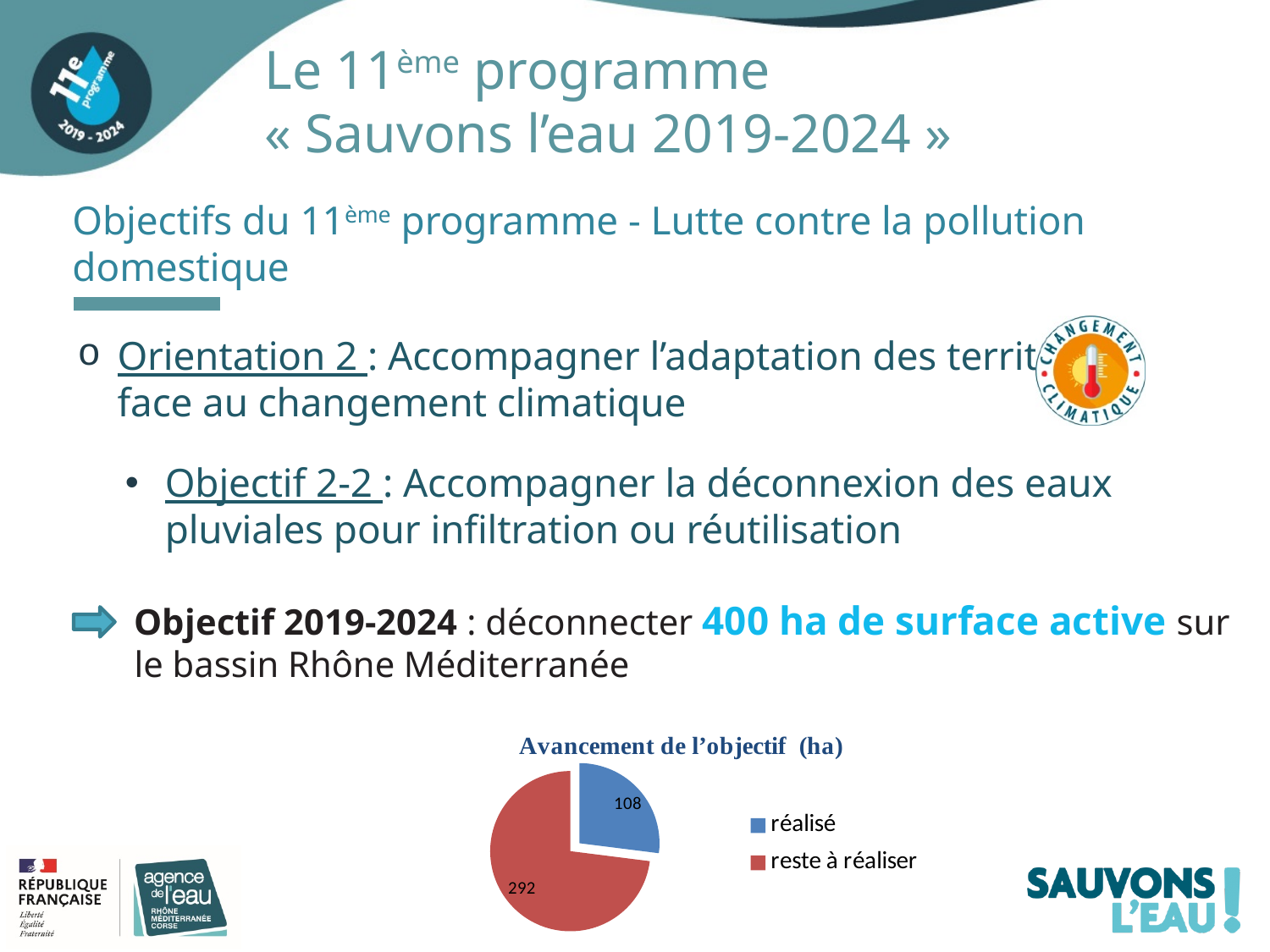
What is the value for "réalisé" in the pie chart? 108 Which is larger, "réalisé" or "reste à réaliser"? reste à réaliser How many entries does the legend of the pie chart list? 2 Which slice of the pie chart is the largest? reste à réaliser What share of the pie does "réalisé" represent? 27% What is the value for "reste à réaliser" in the pie chart? 292 How many slices does the pie chart have? 2 What type of chart is shown on the slide? pie chart What is the total of the two slices in the pie chart? 400 Which slice of the pie chart is the smallest? réalisé What is the title of the chart? Avancement de l'objectif (ha) What is the difference between "reste à réaliser" and "réalisé"? 184